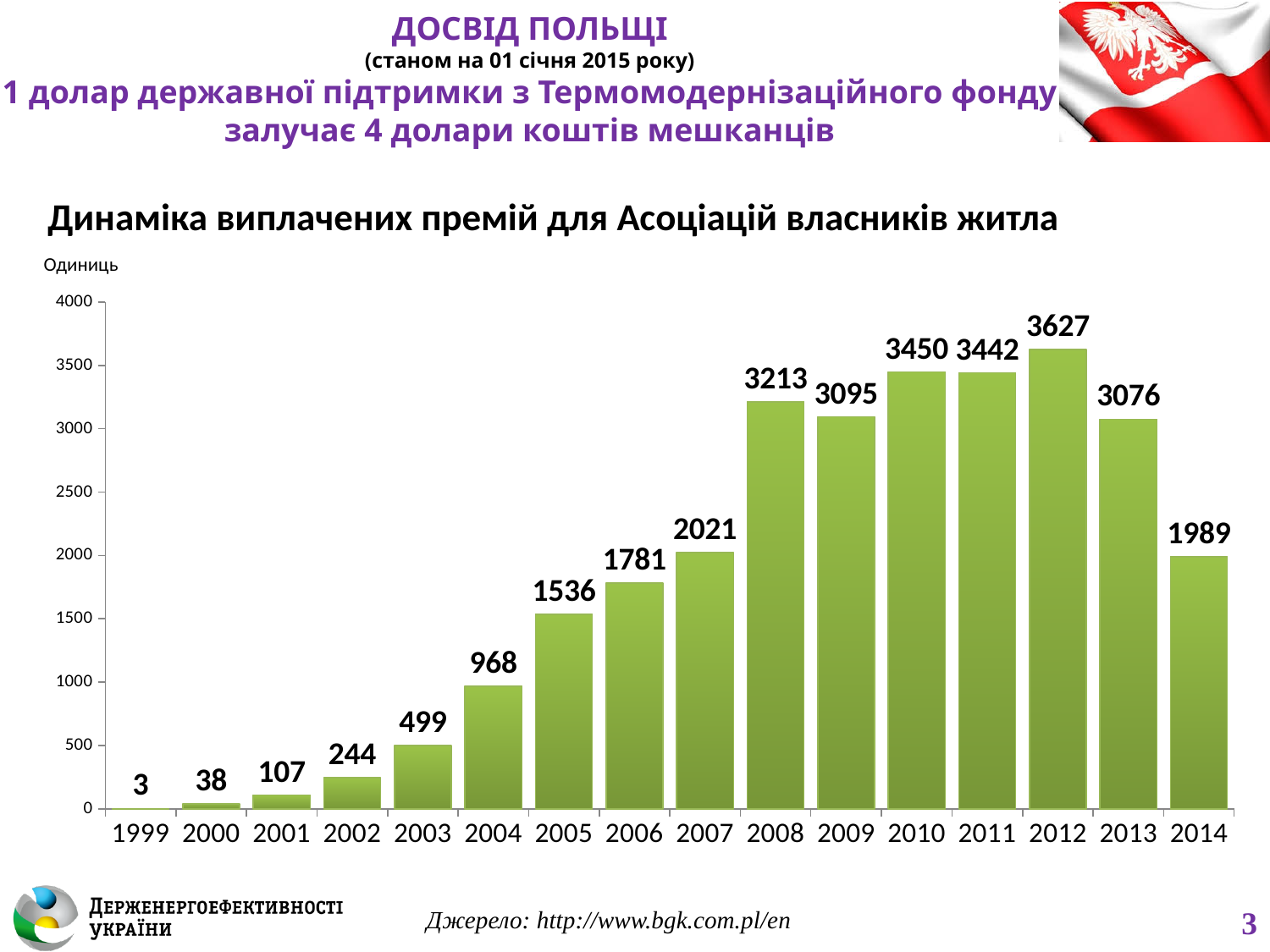
Is the value for 2007 greater or less than 2000? greater What is the value for 2008? 3213 What is the value for 2014? 1989 What is the value for 2004? 968 How many years are shown on the x axis? 16 Which year has the highest value? 2012 What is the title of the chart? Динаміка виплачених премій для Асоціацій власників житла Which is larger, the value for 2010 or the value for 2009? 2010 Do the values rise or fall from 1999 to 2008? rise Which year has the lowest value? 1999 What is the difference between the values for 2012 and 2013? 551 What kind of chart is this? bar chart